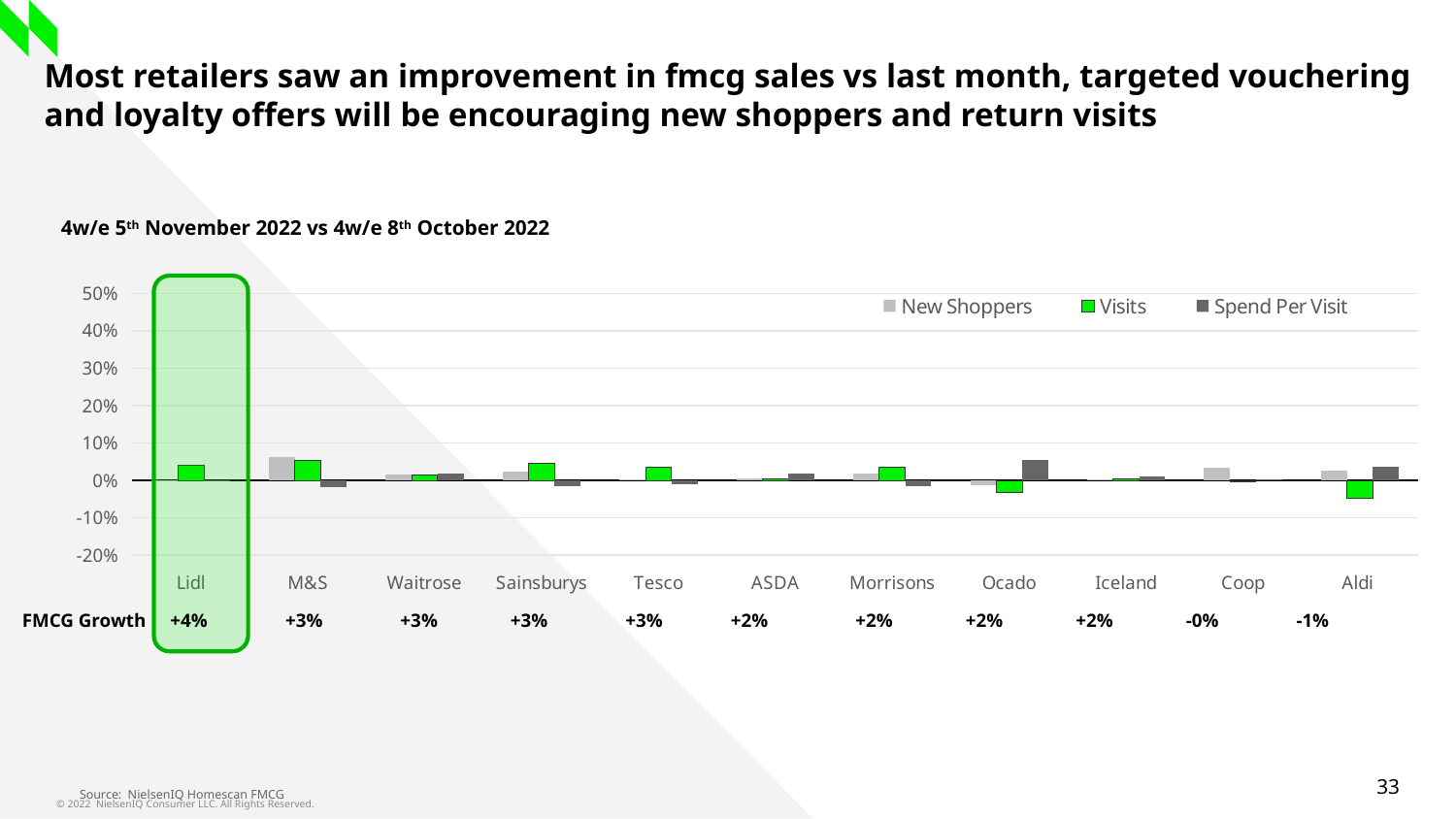
Which has the larger FMCG Growth value, Tesco or Morrisons? Tesco What kind of chart is shown on the slide? bar chart What is the FMCG Growth value shown for Aldi? -1% What is the FMCG Growth value shown for Lidl? +4% Which retailer has the lowest FMCG Growth value shown below the chart? Aldi Which retailer is highlighted with a green box on the chart? Lidl Is the Visits value for Lidl greater or less than 10%? less Which retailer has the highest FMCG Growth value shown below the chart? Lidl How many series does the chart legend list? 3 How many retailers are shown along the x axis of the chart? 11 What is the FMCG Growth value shown for Coop? -0% Is the Visits value for Aldi greater or less than 0%? less